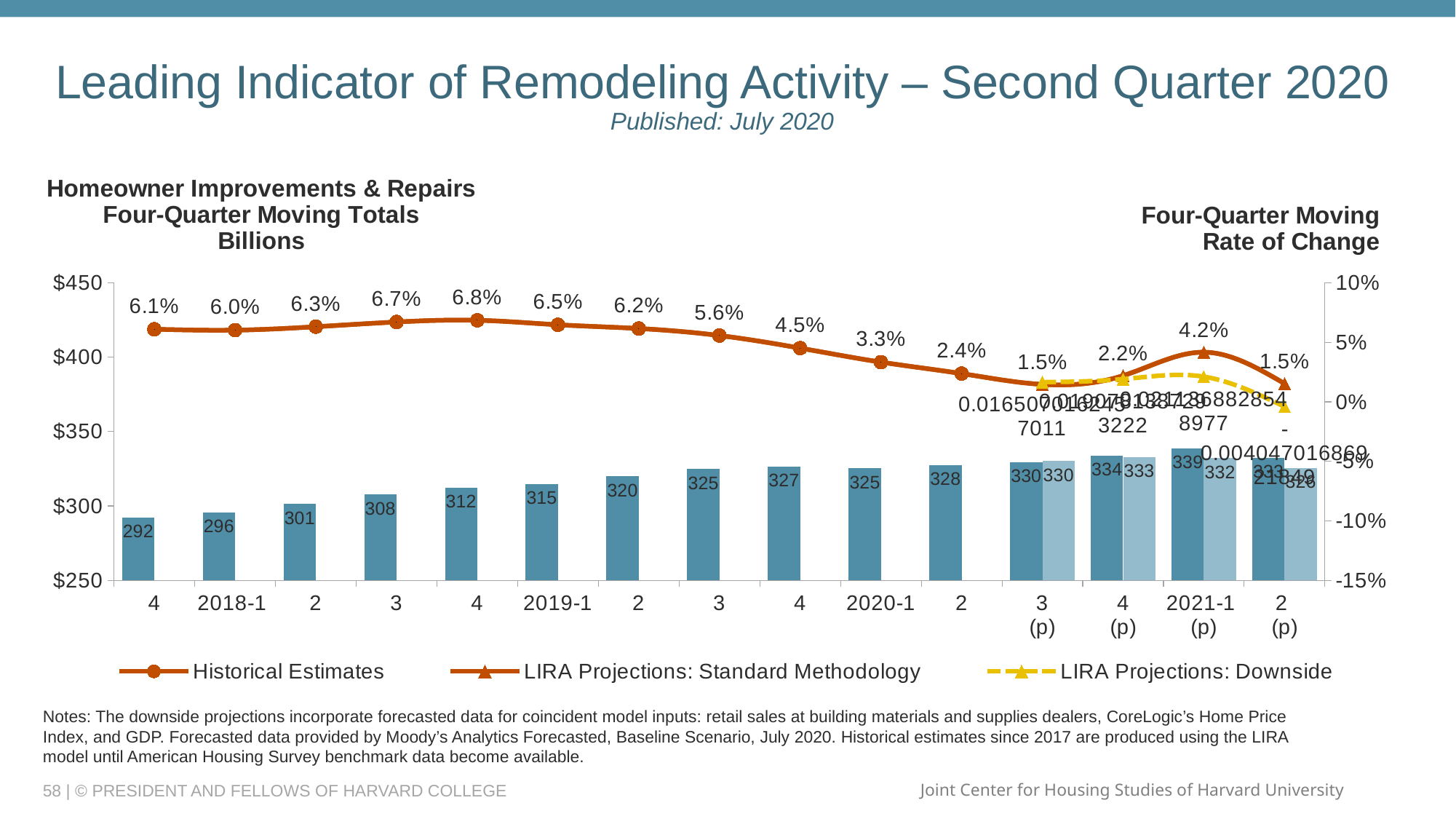
What is the four-quarter moving rate of change shown for 2018-3? 6.7% What is the LIRA Projections: Standard Methodology rate of change for 2021-1 (p)? 4.2% How many quarters are shown on the x axis? 15 What kind of chart is this? Combination bar and line chart What is the four-quarter moving total (in billions) shown for 2019-1? 315 What is the highest rate of change shown on the Historical Estimates line? 6.8% Which has the larger bar value, 2019-3 or 2019-4? 2019-4 What is the lowest value among the bars? 292 What is the difference between the bar values for 2020-2 and 2020-1? 3 Is the rate of change for 2020-1 greater or less than 5%? less Does the Historical Estimates rate of change rise or fall from 2019-1 to 2020-2? fall How many series does the legend list? 3